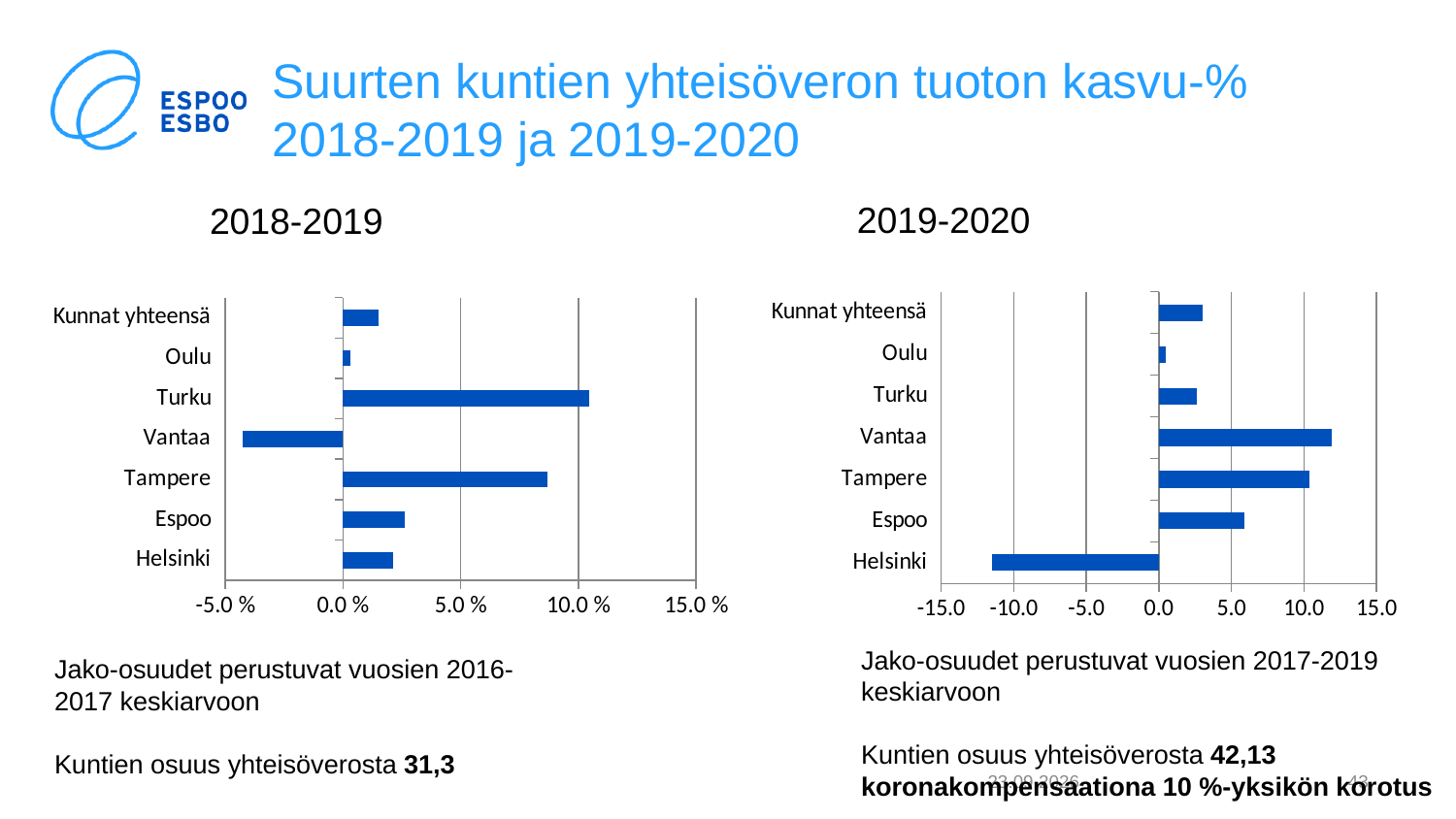
In the 2019-2020 chart, which is larger, the value for Turku or the value for Oulu? Turku In the 2018-2019 chart, how many categories are shown on the vertical axis? 7 In the 2019-2020 chart, which category has the highest value? Vantaa In the 2019-2020 chart, is the value for Espoo greater or less than 5.0? greater In the 2019-2020 chart, is the value for Helsinki greater or less than -10.0? less In the 2019-2020 chart, which category has the lowest value? Helsinki In the 2018-2019 chart, what kind of chart is used? bar chart What is the title of the chart on the right side of the slide? 2019-2020 In the 2018-2019 chart, is the value for Turku greater or less than 10.0 %? greater In the 2018-2019 chart, which is larger, the value for Tampere or the value for Espoo? Tampere In the 2018-2019 chart, which category has the highest value? Turku In the 2018-2019 chart, which category has the lowest value? Vantaa